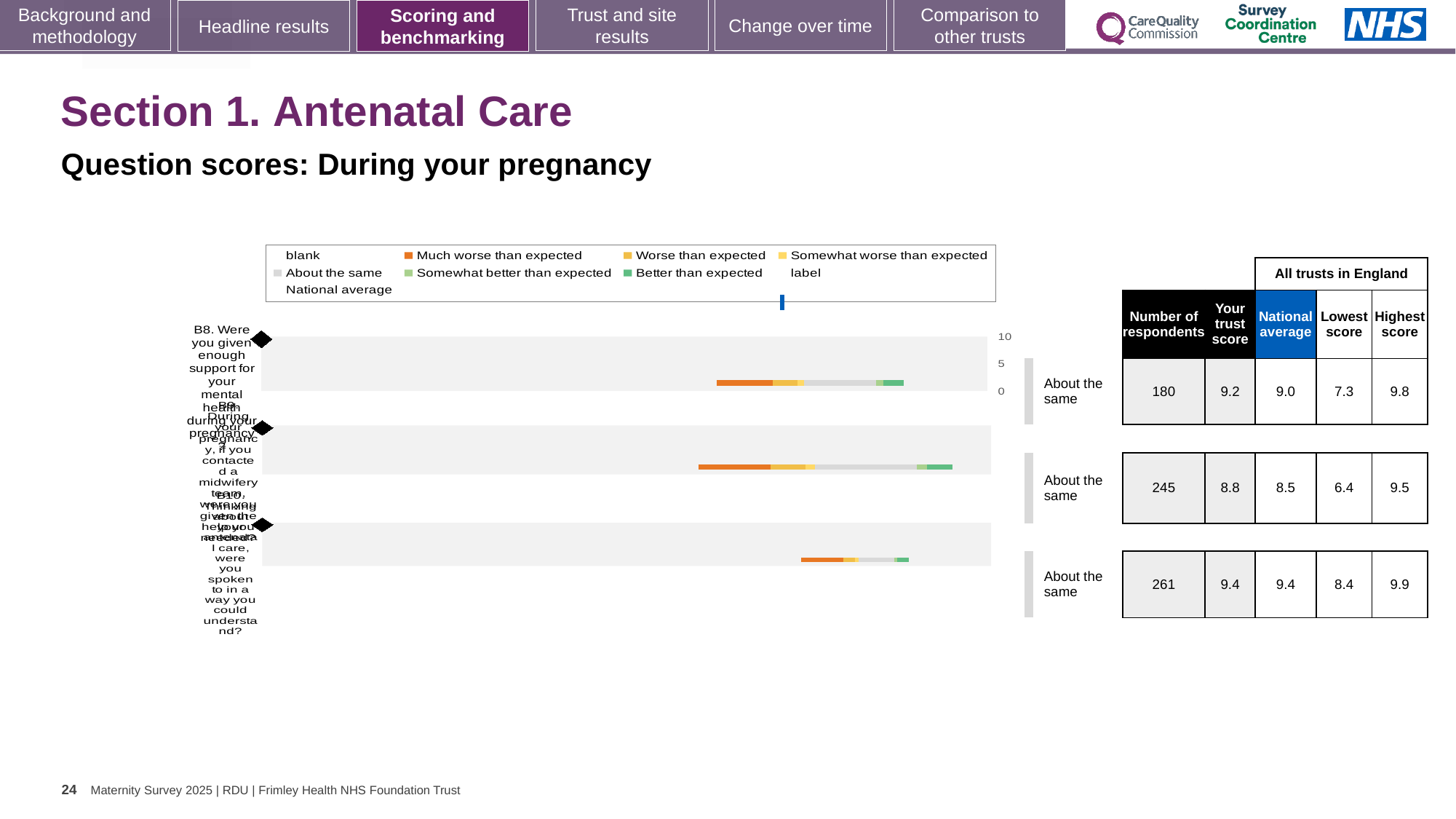
Which row has the highest trust score? bottom row (9.4) By how much does the trust score exceed the national average in the middle row? 0.3 What is the highest score across all trusts in England for the top row (B8)? 9.8 How many question bars are plotted in the chart? 3 What is the national average for the bottom row of the table? 9.4 What benchmark category is shown for all three questions? About the same Which row has more respondents, the top row or the bottom row? bottom row (261) What is the trust score for the middle row of the table? 8.8 What is the number of respondents for the top row (B8, support for your mental health during pregnancy)? 180 What kind of chart is shown on the slide? bar chart What is the subtitle describing the chart's question scores? Question scores: During your pregnancy What is the lowest score across all trusts in England for the middle row? 6.4